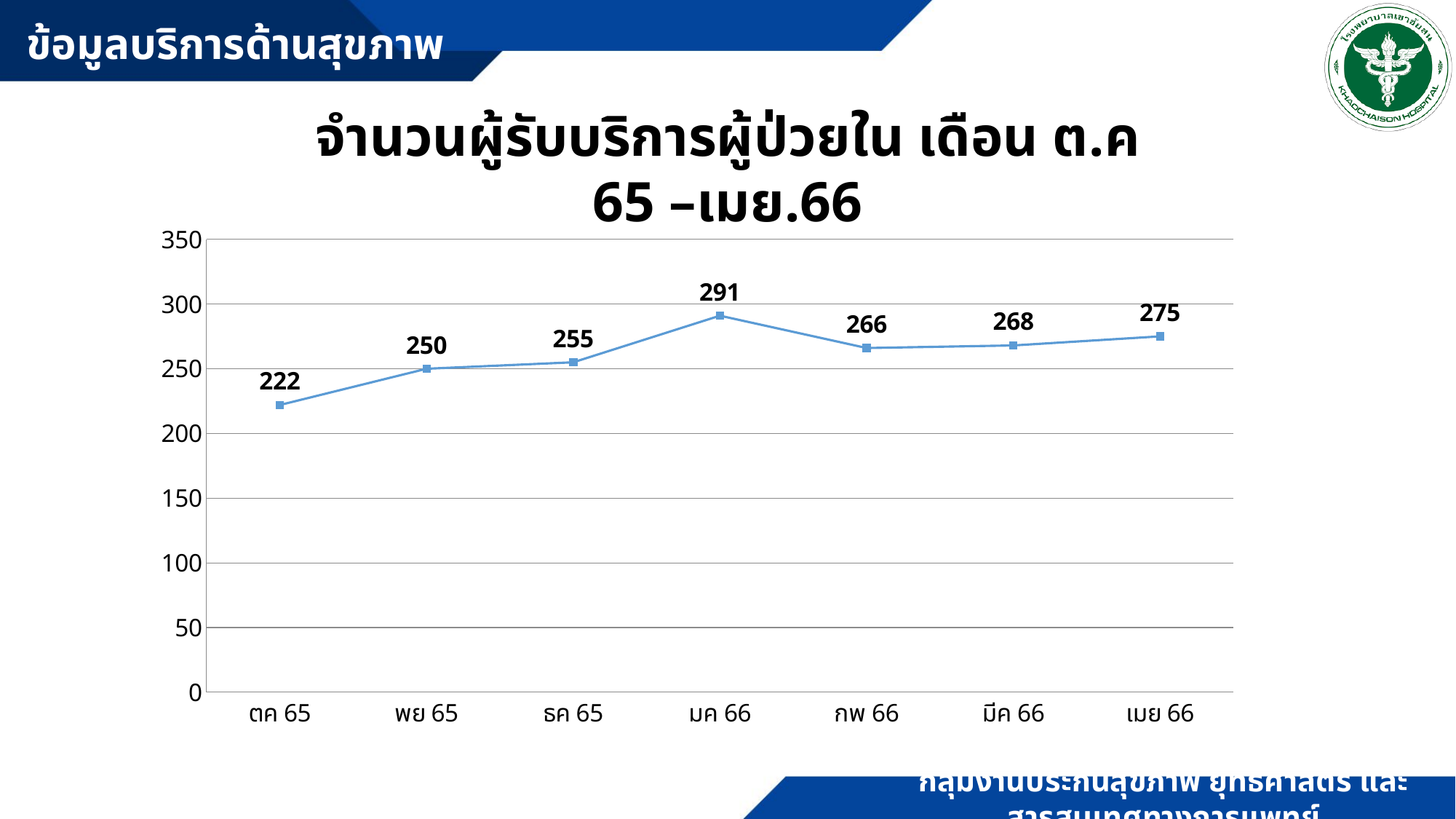
Which month has the highest value? มค 66 What is the difference between the values for มค 66 and กพ 66? 25 What is the difference between the values for เมย 66 and ตค 65? 53 Which is larger, the value for พย 65 or the value for มีค 66? มีค 66 What is the value for มค 66? 291 What kind of chart is shown on the slide? line chart What is the value for ตค 65? 222 How many months are plotted on the chart? 7 Which month has the lowest value? ตค 65 Is the value for ธค 65 greater or less than 300? less What is the value for เมย 66? 275 Does the value rise or fall from ตค 65 to มค 66? rise